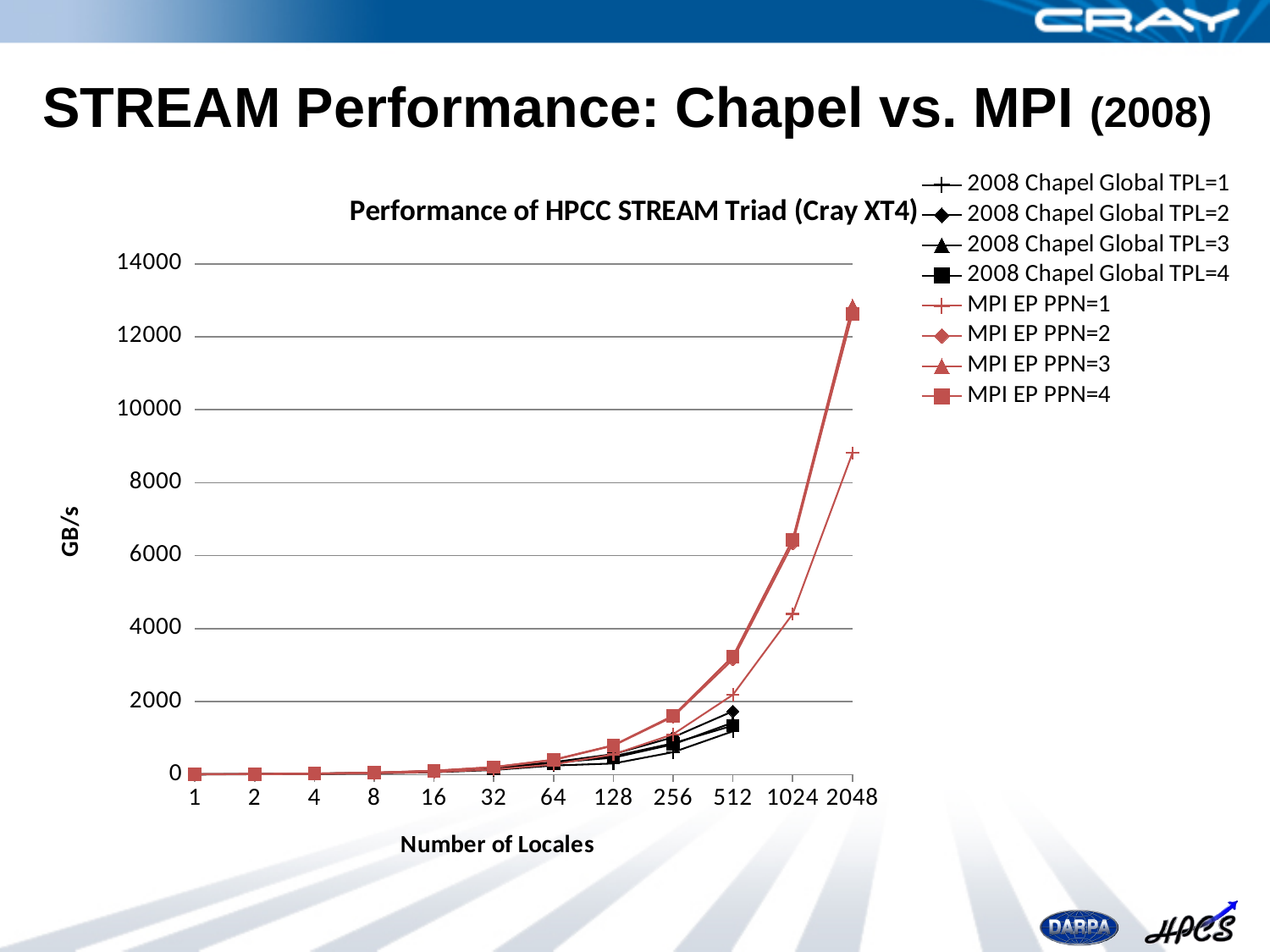
Do the values for MPI EP PPN=4 rise or fall as the number of locales increases? rise Is the value for MPI EP PPN=1 at 2048 locales greater or less than 8000? greater How many series does the legend list? 8 Is the value for MPI EP PPN=1 at 1024 locales greater or less than 4000? greater What is the label of the y axis? GB/s What kind of chart is shown on the slide? line chart Is the value for MPI EP PPN=4 at 2048 locales greater or less than 12000? greater What is the title of the chart? Performance of HPCC STREAM Triad (Cray XT4) At 2048 locales, which is larger: MPI EP PPN=4 or MPI EP PPN=1? MPI EP PPN=4 How many categories are shown on the x axis (Number of Locales)? 12